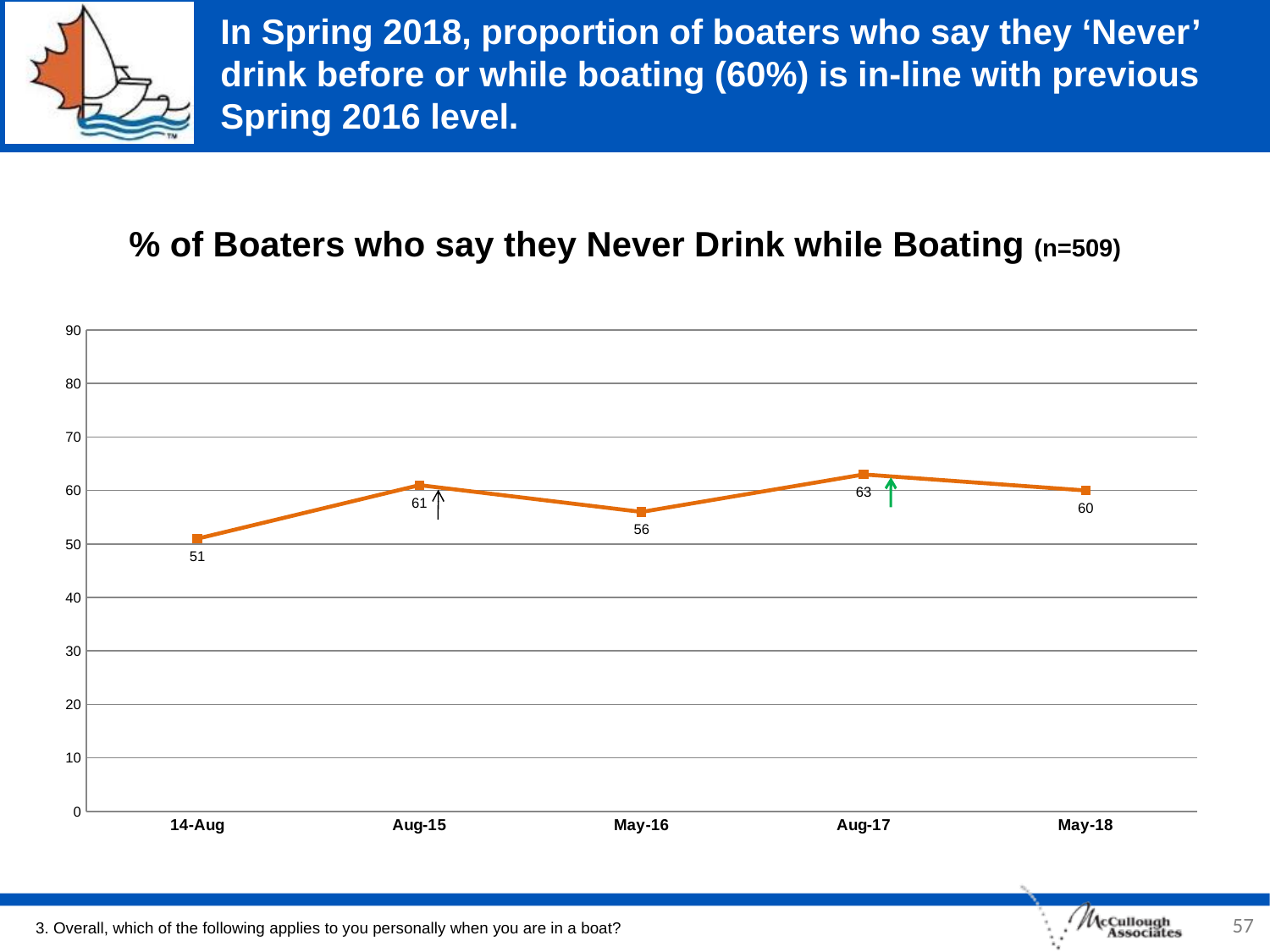
Is the value for 14-Aug greater or less than 60? less How many time periods are plotted on the chart? 5 Which period has the lowest value? 14-Aug What is the difference between the values for Aug-15 and 14-Aug? 10 What is the value for May-16? 56 What is the value for May-18? 60 What kind of chart is shown on the slide? line chart What is the difference between the values for Aug-17 and May-16? 7 What is the title of the chart? % of Boaters who say they Never Drink while Boating (n=509) What is the value for 14-Aug? 51 Which is larger, the value for Aug-15 or the value for May-16? Aug-15 Which period has the highest value? Aug-17